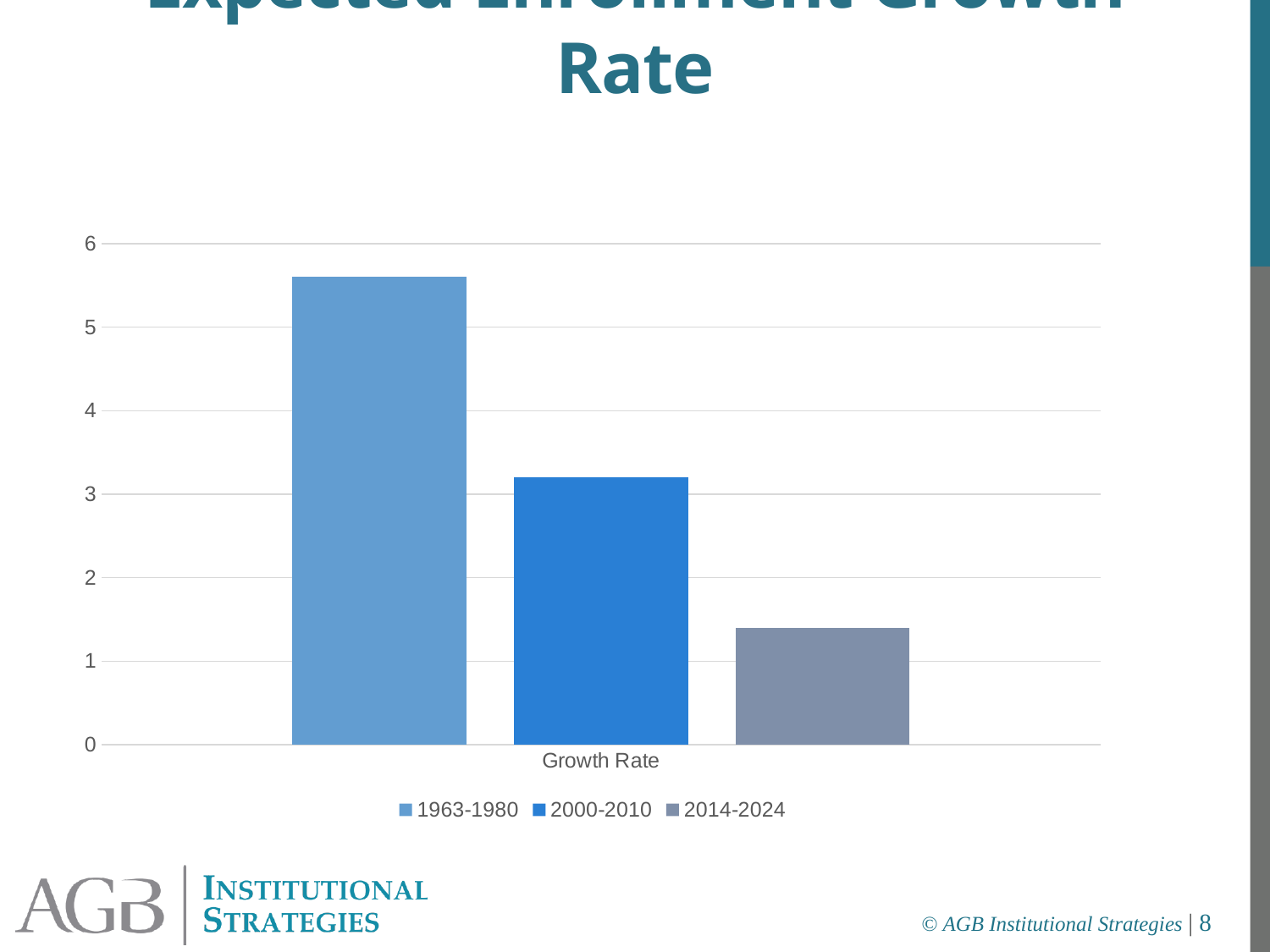
Is the value for 1963-1980 greater or less than 6? less Which is larger, the growth rate for 1963-1980 or for 2000-2010? 1963-1980 What kind of chart is shown on the slide? bar chart Which series has the highest growth rate? 1963-1980 How many series does the legend list? 3 Which is larger, the growth rate for 2000-2010 or for 2014-2024? 2000-2010 Is the value for 2014-2024 greater or less than 2? less Which series has the lowest growth rate? 2014-2024 Which series is shown in the grey bar? 2014-2024 Is the value for 1963-1980 greater or less than 5? greater What is the label on the category axis of the chart? Growth Rate